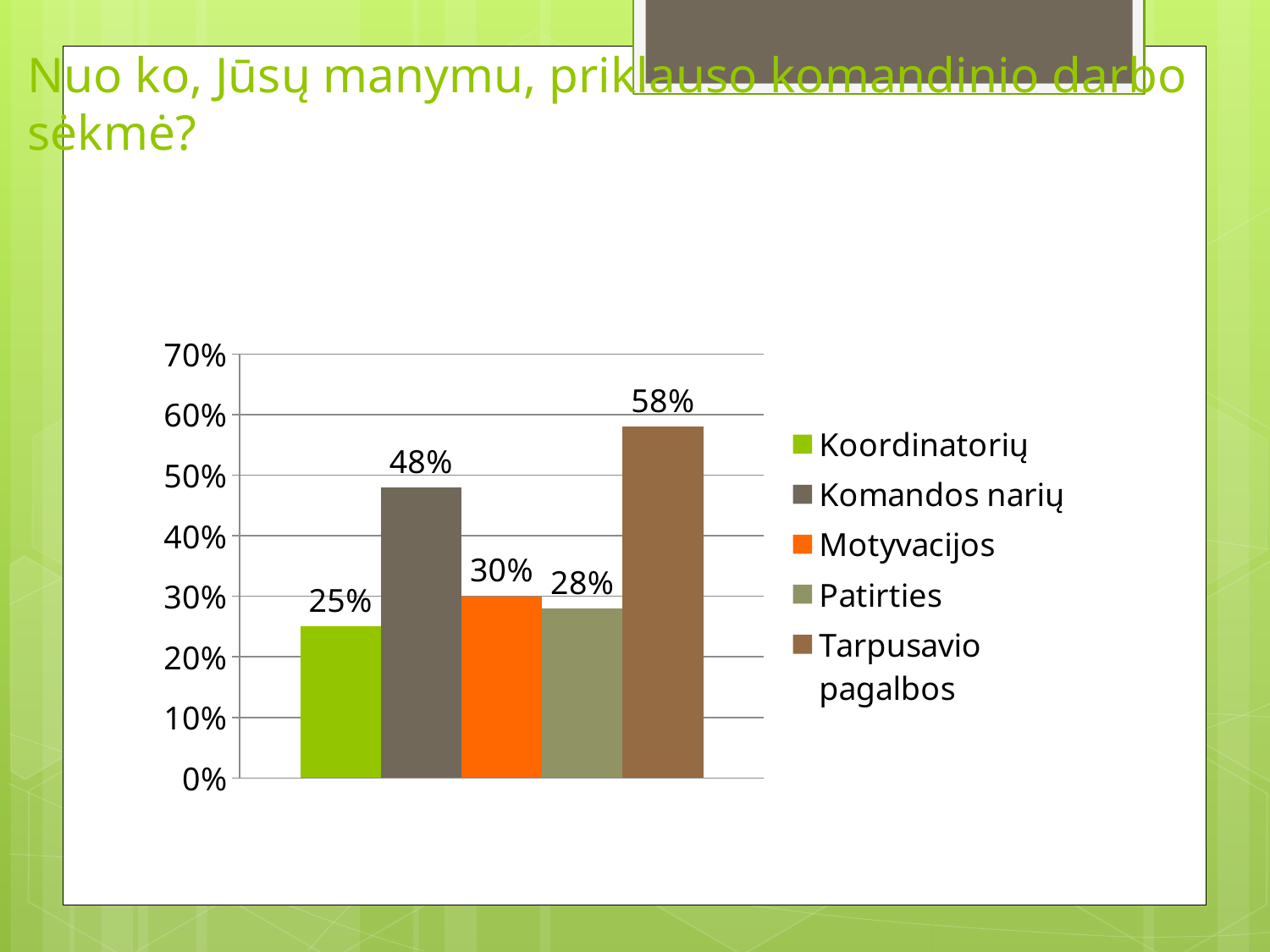
What kind of chart is shown on the slide? bar chart What is the value for Komandos narių? 48% How many series does the legend list? 5 What is the difference between the values for Tarpusavio pagalbos and Komandos narių? 10% Is the value for Komandos narių greater or less than 40%? greater Which series has the lowest value? Koordinatorių What is the value for Koordinatorių? 25% Which is larger, the value for Motyvacijos or the value for Koordinatorių? Motyvacijos What is the difference between the values for Motyvacijos and Patirties? 2% What colour is the bar for Motyvacijos? orange What is the value for Tarpusavio pagalbos? 58% Which series has the highest value? Tarpusavio pagalbos